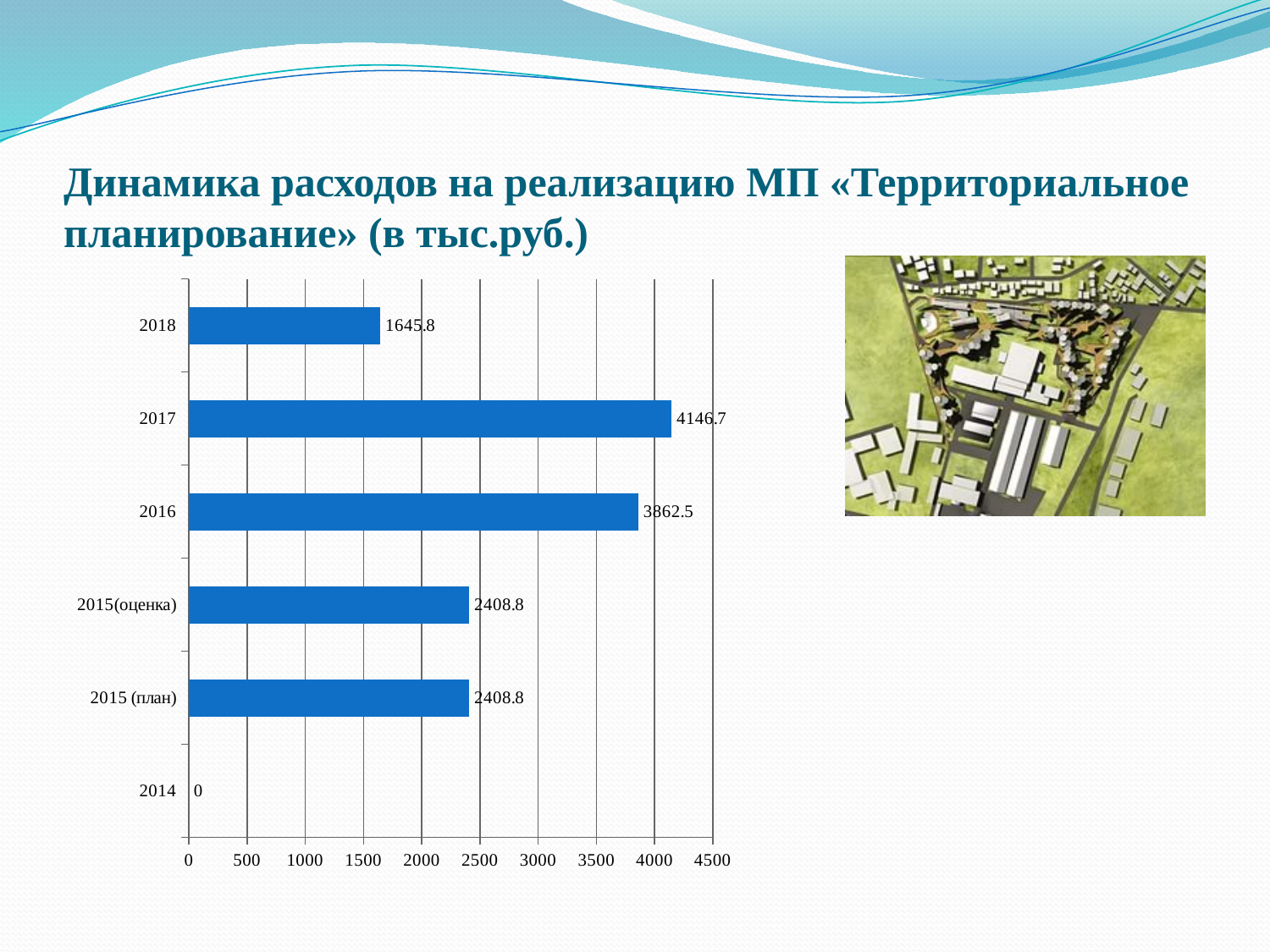
What is the difference between the values for 2017 and 2016? 284.2 Which category has the lowest value? 2014 How many categories are shown on the chart? 6 What is the value for 2016? 3862.5 What is the difference between the values for 2016 and 2018? 2216.7 Is the value for 2018 greater or less than 2000? less What is the value for 2014? 0 What kind of chart is shown on the slide? bar chart Which category has the highest value? 2017 What is the value for 2017? 4146.7 Which is larger, the value for 2016 or the value for 2015(оценка)? 2016 What is the value for 2018? 1645.8